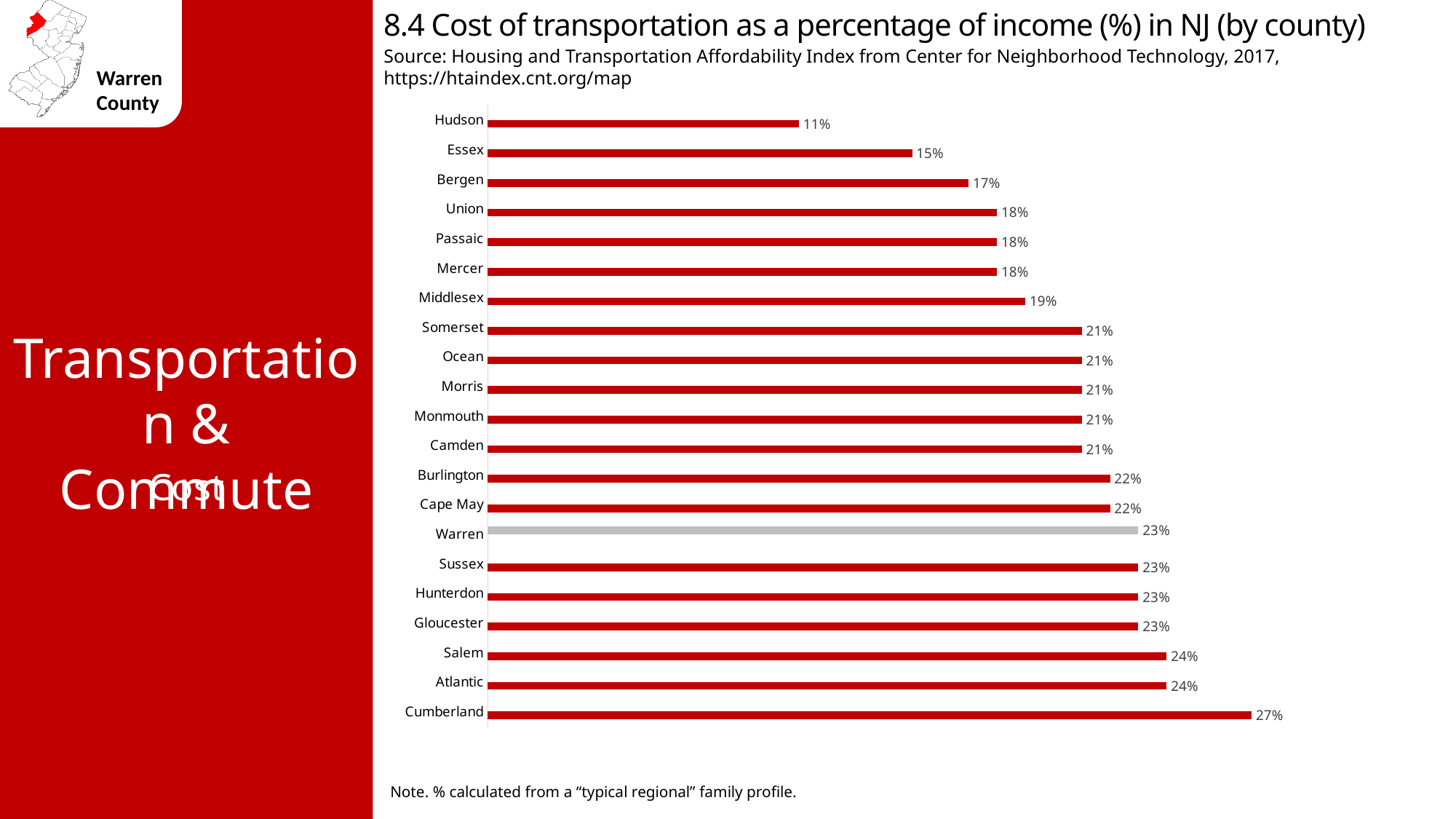
What is the value shown for Middlesex County? 19% What is the difference between the values for Cumberland and Hudson? 16% What is the cost of transportation as a percentage of income for Hudson County? 11% What type of chart is shown on the slide? Bar chart Which county has the highest cost of transportation as a percentage of income? Cumberland What is the value shown for Atlantic County? 24% Which county's bar is shown in gray instead of red? Warren What is the cost of transportation as a percentage of income for Warren County? 23% What is the difference between the values for Warren and Essex? 8% How many counties are shown in the chart? 21 Which county has the lowest cost of transportation as a percentage of income? Hudson Which has a higher value, Bergen or Salem? Salem